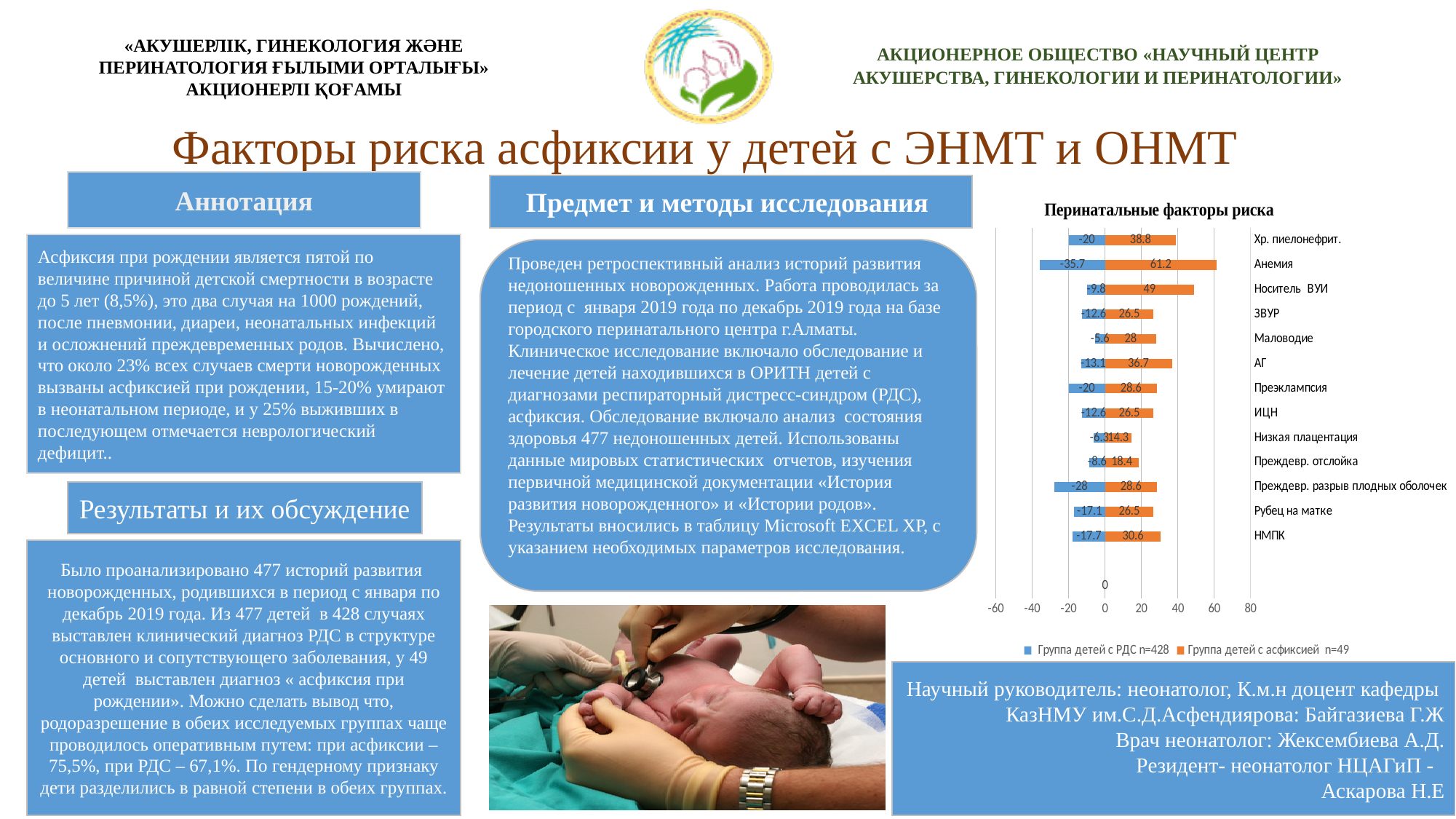
What kind of chart is used to show the perinatal risk factors? bar chart What is the value for НМПК in the series Группа детей с РДС n=428? -17.7 What is the value for Носитель ВУИ in the series Группа детей с асфиксией n=49? 49 How many series does the legend of the chart list? 2 How many risk factor categories are shown in the chart? 13 What is the difference between the values for Хр. пиелонефрит and Преэклампсия in the series Группа детей с асфиксией n=49? 10.2 What is the value for Анемия in the series Группа детей с РДС n=428? -35.7 What is the value for Анемия in the series Группа детей с асфиксией n=49? 61.2 Which is larger in the series Группа детей с асфиксией n=49: the value for АГ or the value for Маловодие? АГ What is the title of the chart on the right side of the slide? Перинатальные факторы риска Which category has the highest value in the series Группа детей с асфиксией n=49? Анемия Which category has the lowest value in the series Группа детей с асфиксией n=49? Низкая плацентация